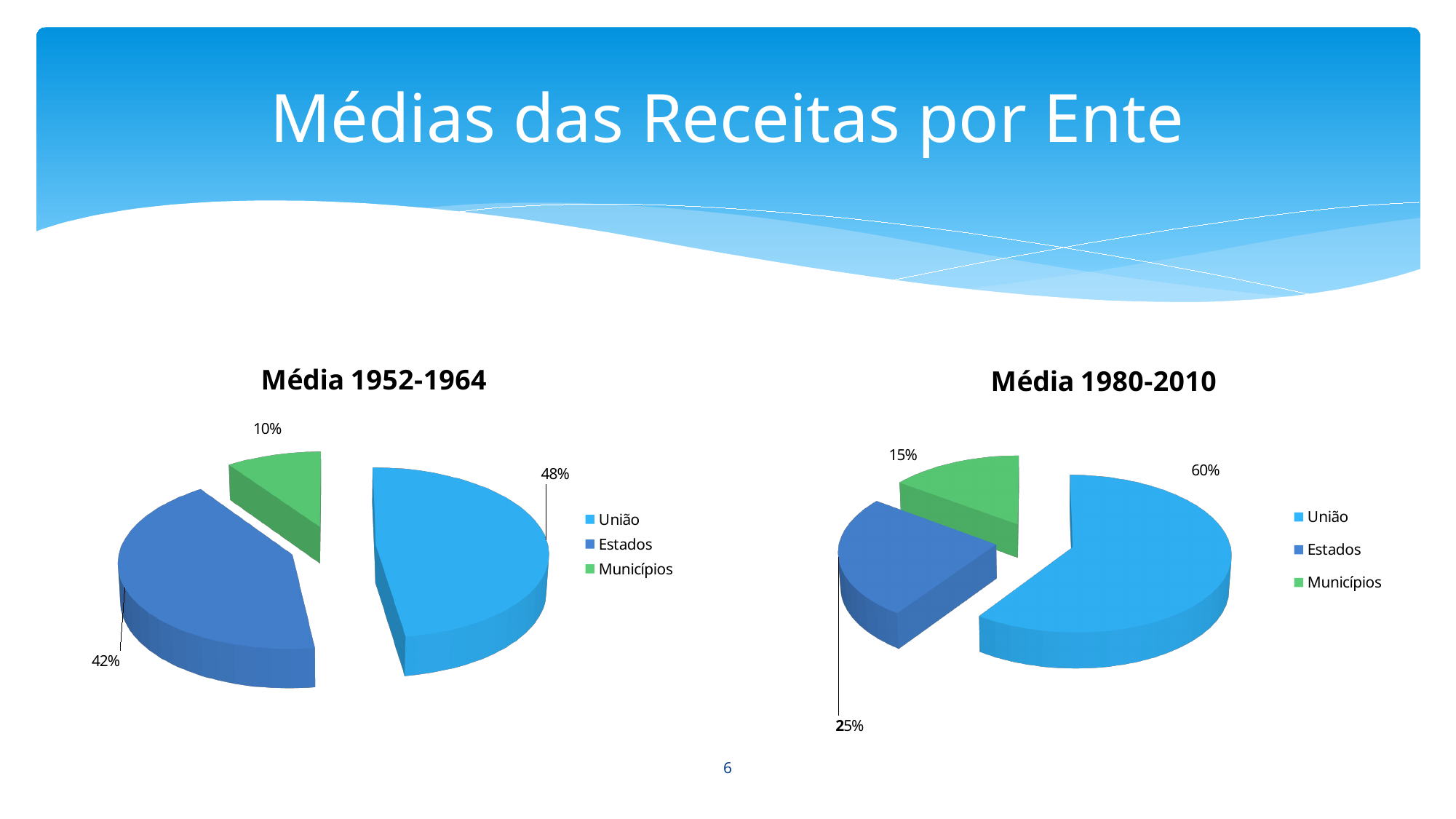
In the 'Média 1980-2010' chart, what share does Municípios have? 15% In the 'Média 1980-2010' chart, what share does União have? 60% In the 'Média 1952-1964' chart, what is the difference in percentage points between União and Estados? 6 percentage points What type of chart is the 'Média 1980-2010' chart? Pie chart In the 'Média 1952-1964' chart, what share does Estados have? 42% In the 'Média 1980-2010' chart, what share does Estados have? 25% How many entries does the legend of the 'Média 1952-1964' chart list? 3 In the 'Média 1980-2010' chart, what is the difference in percentage points between União and Estados? 35 percentage points In the 'Média 1952-1964' chart, what share does União have? 48% In the 'Média 1952-1964' chart, which category has the largest slice? União In the 'Média 1980-2010' chart, which category has the smallest slice? Municípios In the 'Média 1952-1964' chart, what share does Municípios have? 10%